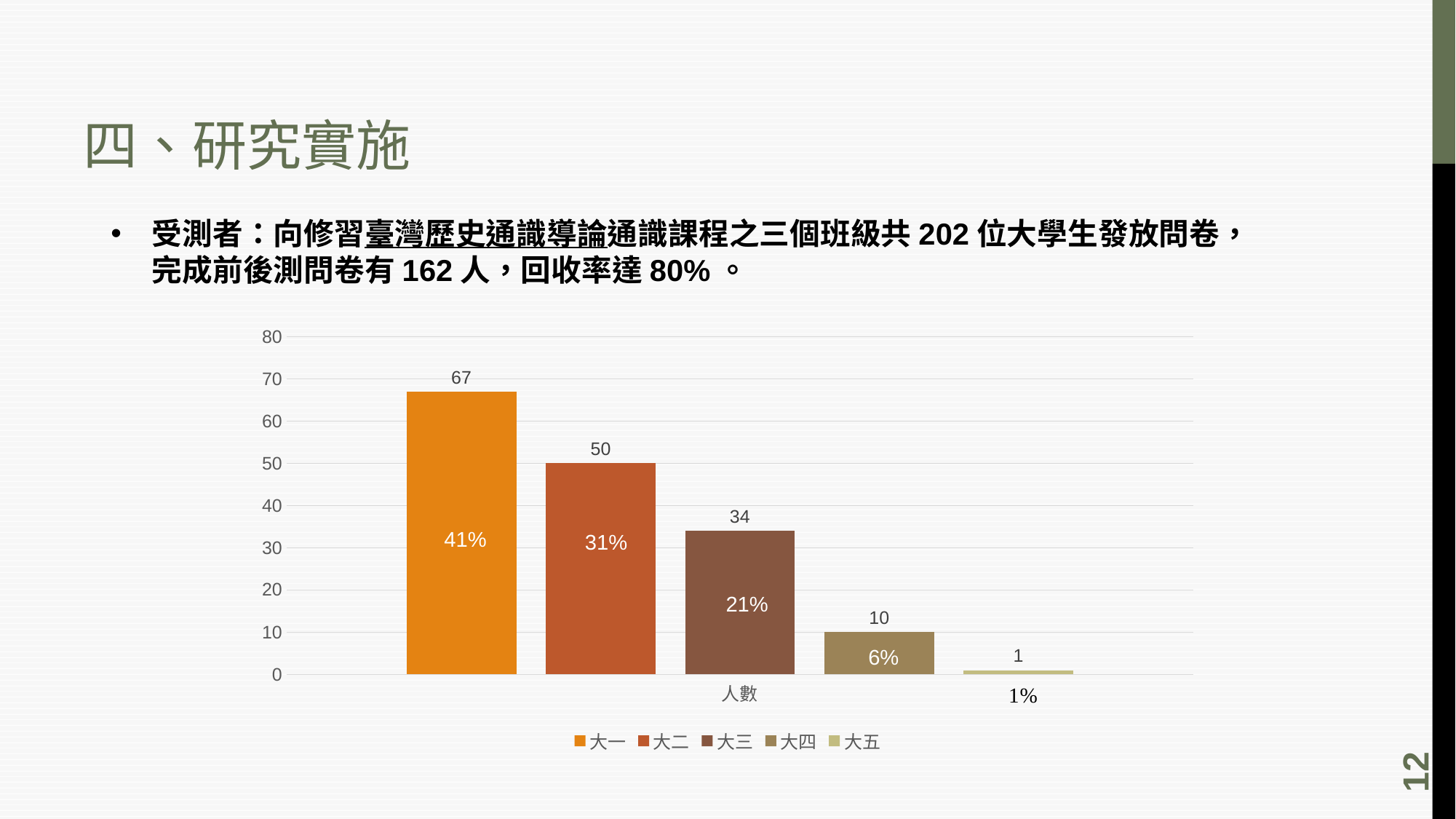
Which series has the lowest value? 大五 What is the value for 大一? 67 Which series has the highest value? 大一 What is the value for 大五? 1 What is the total of the values for all five series? 162 What is the difference between the values for 大一 and 大二? 17 What is the value for 大三? 34 What is the category label shown on the x axis? 人數 What percentage label is shown on the 大二 bar? 31% Which is larger, the value for 大三 or the value for 大四? 大三 What kind of chart is shown on the slide? bar chart How many series does the legend list? 5